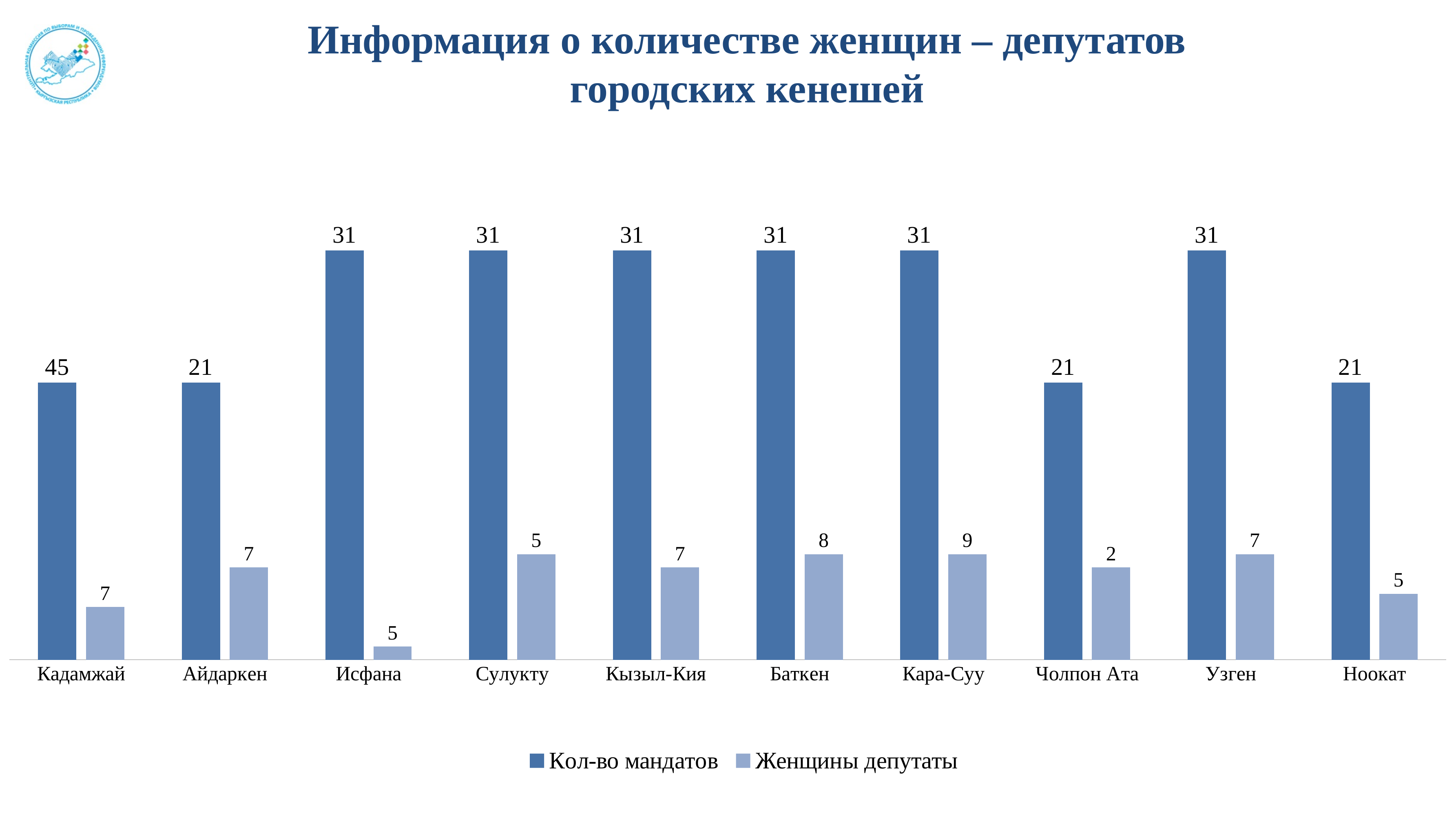
What is the difference between "Кол-во мандатов" and "Женщины депутаты" for Баткен? 23 What is the value of "Женщины депутаты" for Чолпон Ата? 2 How many cities are shown on the x axis? 10 Which city has the highest value for "Женщины депутаты"? Кара-Суу How many series does the legend list? 2 What kind of chart is shown on the slide? Bar chart What is the value of "Кол-во мандатов" for Кадамжай? 45 What is the value of "Женщины депутаты" for Кара-Суу? 9 Which city has the highest value for "Кол-во мандатов"? Кадамжай Which city has the lowest value for "Женщины депутаты"? Чолпон Ата Which is larger: "Женщины депутаты" for Айдаркен or for Исфана? Айдаркен What is the title of the chart on the slide? Информация о количестве женщин – депутатов городских кенешей